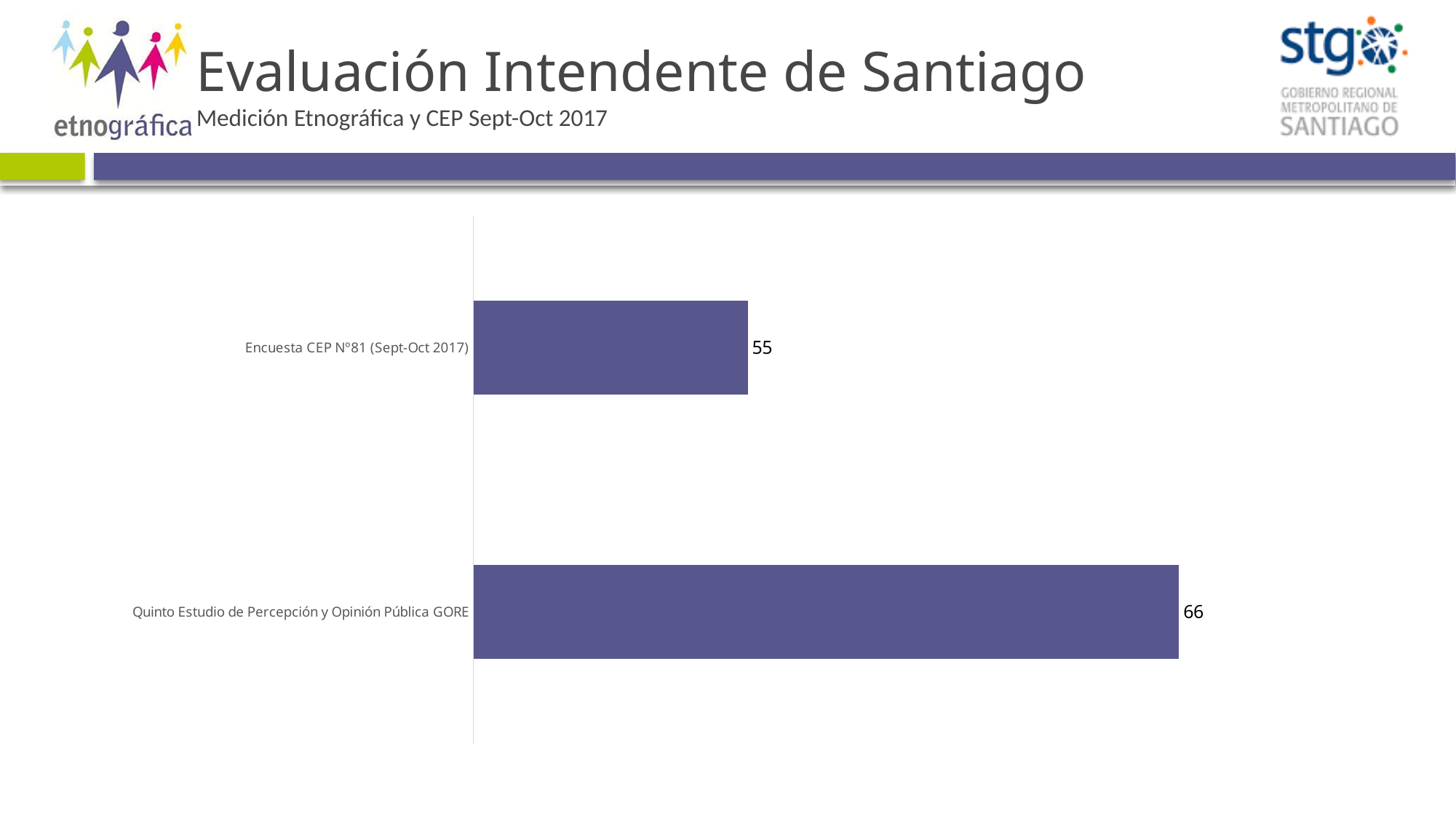
What is the value for Encuesta CEP Nº81 (Sept-Oct 2017)? 55 Which category has the lowest value? Encuesta CEP Nº81 (Sept-Oct 2017) What is the value for Quinto Estudio de Percepción y Opinión Pública GORE? 66 What is the difference between the value for Quinto Estudio de Percepción y Opinión Pública GORE and the value for Encuesta CEP Nº81 (Sept-Oct 2017)? 11 What kind of chart is shown on the slide? Bar chart Which is larger: the value for Encuesta CEP Nº81 (Sept-Oct 2017) or the value for Quinto Estudio de Percepción y Opinión Pública GORE? Quinto Estudio de Percepción y Opinión Pública GORE How many categories are shown in the chart? 2 What is the title of the slide? Evaluación Intendente de Santiago What colour are the bars in the chart? Purple Which category has the highest value? Quinto Estudio de Percepción y Opinión Pública GORE